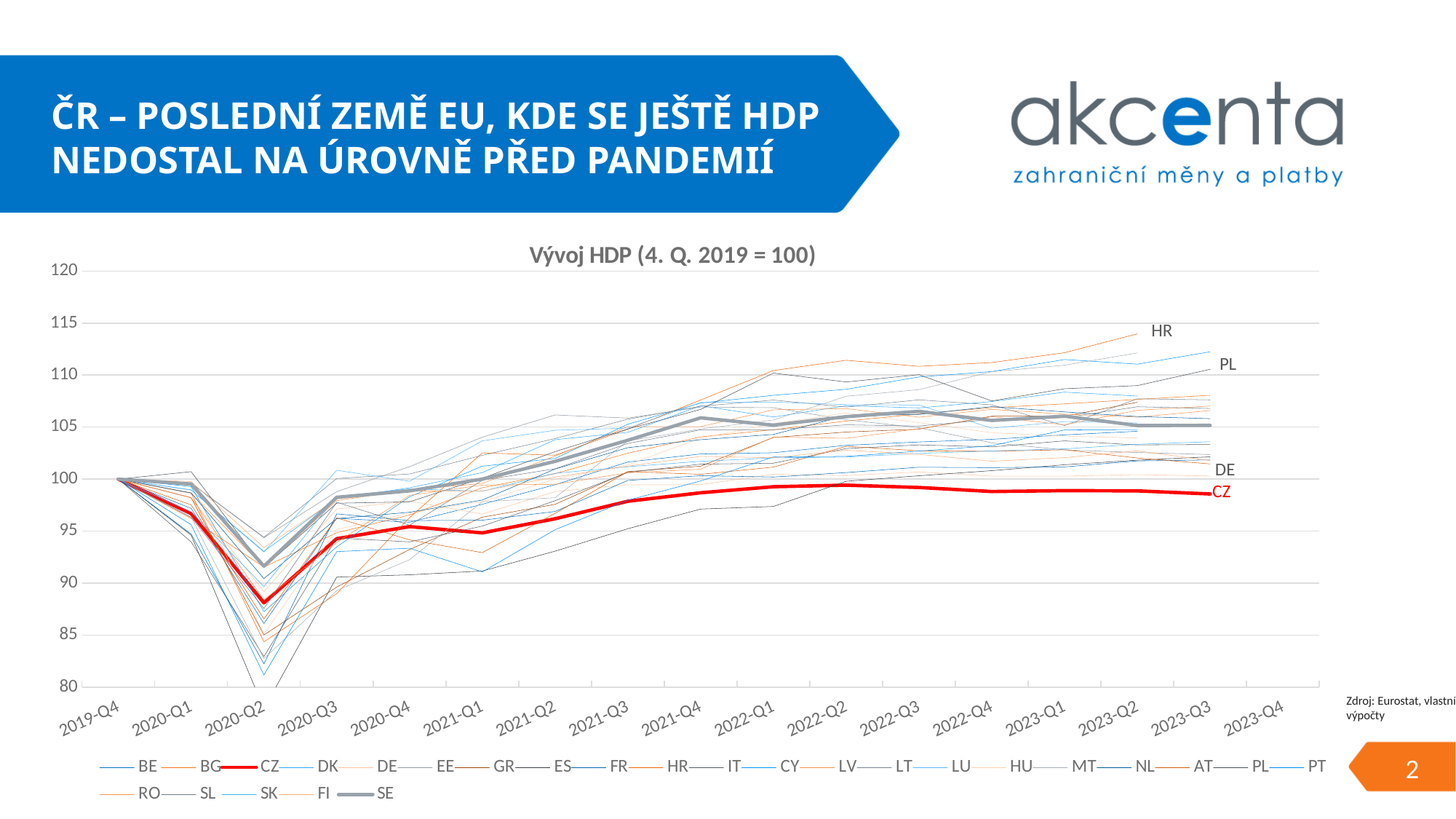
Does the CZ series rise or fall between 2020-Q2 and 2023-Q3? rise Is the value for CZ at 2020-Q2 greater or less than 90? less Which labelled series has the highest value at 2023-Q3? PL How many quarter labels are shown on the x axis? 17 At 2023-Q3, which is larger, the value for DE or the value for CZ? DE What kind of chart is shown on the slide? line chart Is the value for CZ at 2023-Q3 greater or less than 100? less What is the value of the CZ series at 2019-Q4? 100 How many series does the chart legend list? 26 What is the title of the chart? Vývoj HDP (4. Q. 2019 = 100) Which labelled series has the lowest value at 2023-Q3? CZ